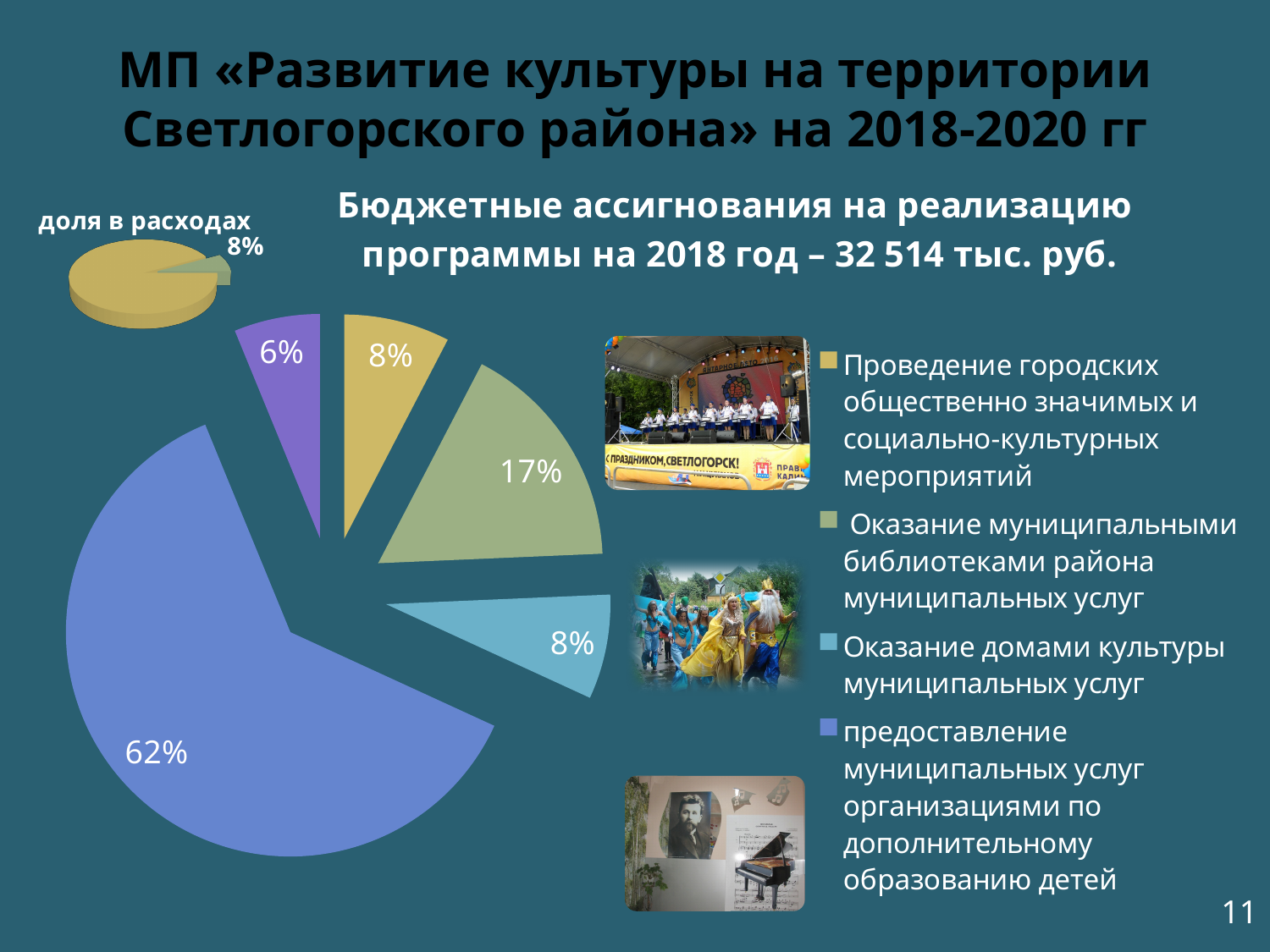
In the large pie chart, what share is shown for «Оказание домами культуры муниципальных услуг»? 8% What kind of chart is the large chart on the slide? pie chart How many entries does the legend of the large pie chart list? 4 How many slices does the large pie chart have? 5 In the large pie chart, which category has the largest share? предоставление муниципальных услуг организациями по дополнительному образованию детей In the large pie chart, what share is shown for «Оказание муниципальными библиотеками района муниципальных услуг»? 17% What share is labelled on the small pie chart titled «доля в расходах» in the top left? 8% In the large pie chart, what is the difference in percentage points between the 62% slice and the 17% slice? 45 In the large pie chart, which has the larger share: «Оказание муниципальными библиотеками района муниципальных услуг» or «Оказание домами культуры муниципальных услуг»? Оказание муниципальными библиотеками района муниципальных услуг In the large pie chart, what share is labelled on the largest slice? 62% In the large pie chart, what is the smallest labelled share? 6% In the large pie chart, what share is shown for «Проведение городских общественно значимых и социально-культурных мероприятий»? 8%